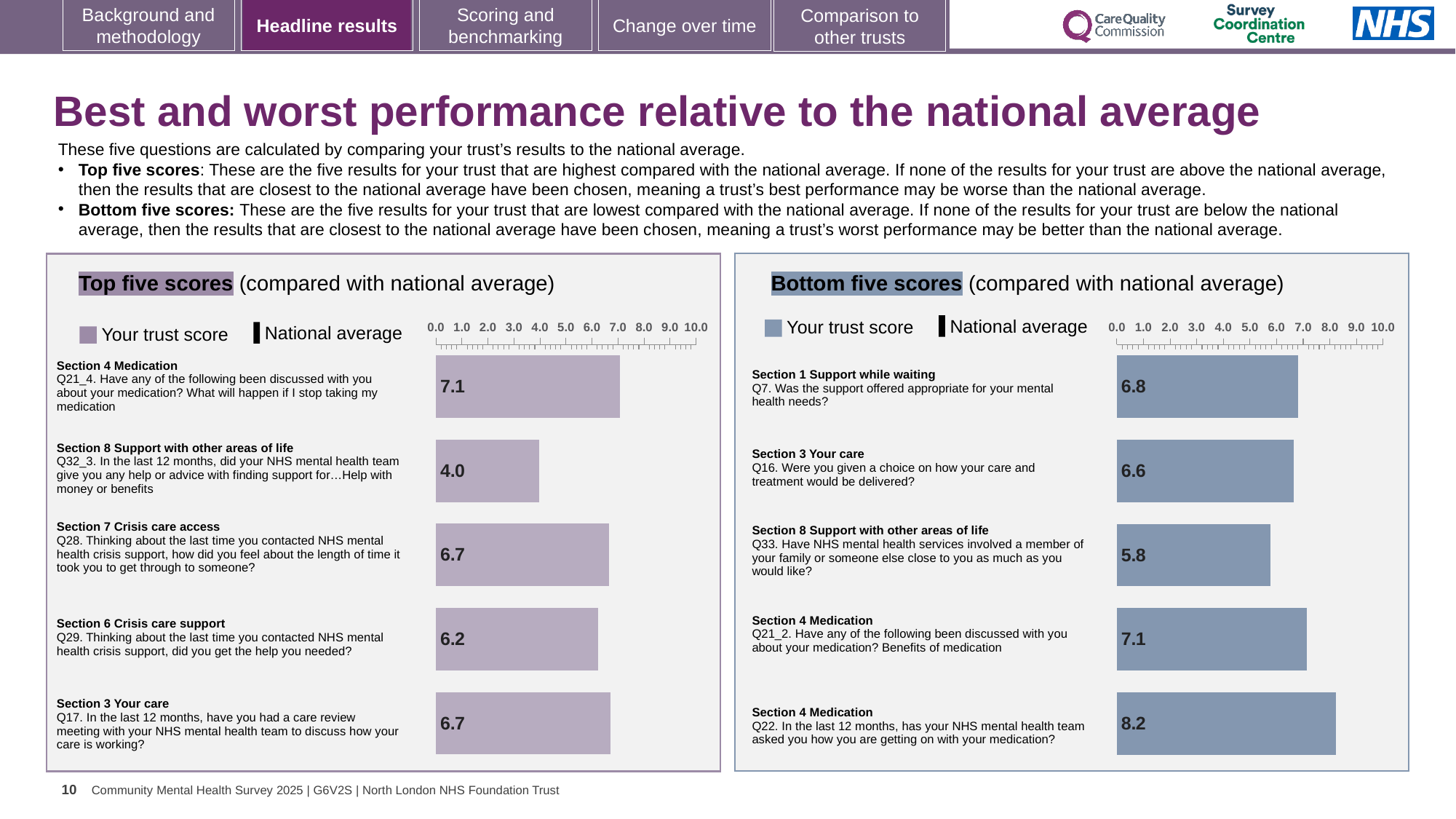
In the 'Top five scores' chart, what is the trust score for Q21_4 (Section 4 Medication)? 7.1 What type of chart is used in the 'Bottom five scores' panel? Bar chart In the 'Bottom five scores' chart, what is the trust score for Q33 (Section 8 Support with other areas of life)? 5.8 In the 'Bottom five scores' chart, which question has the highest trust score? Q22 In the 'Top five scores' chart, which question has the highest trust score? Q21_4 In the 'Top five scores' chart, what is the trust score for Q32_3 (Section 8 Support with other areas of life)? 4.0 How many bars are plotted in the 'Top five scores' chart? 5 In the 'Bottom five scores' chart, what is the trust score for Q22 (Section 4 Medication)? 8.2 In the 'Bottom five scores' chart, what is the difference between the trust scores for Q22 and Q33? 2.4 In the 'Top five scores' chart, which question has the lowest trust score? Q32_3 In the 'Bottom five scores' chart, which is larger, the trust score for Q7 or for Q16? Q7 In the 'Top five scores' chart, what is the difference between the trust scores for Q21_4 and Q32_3? 3.1